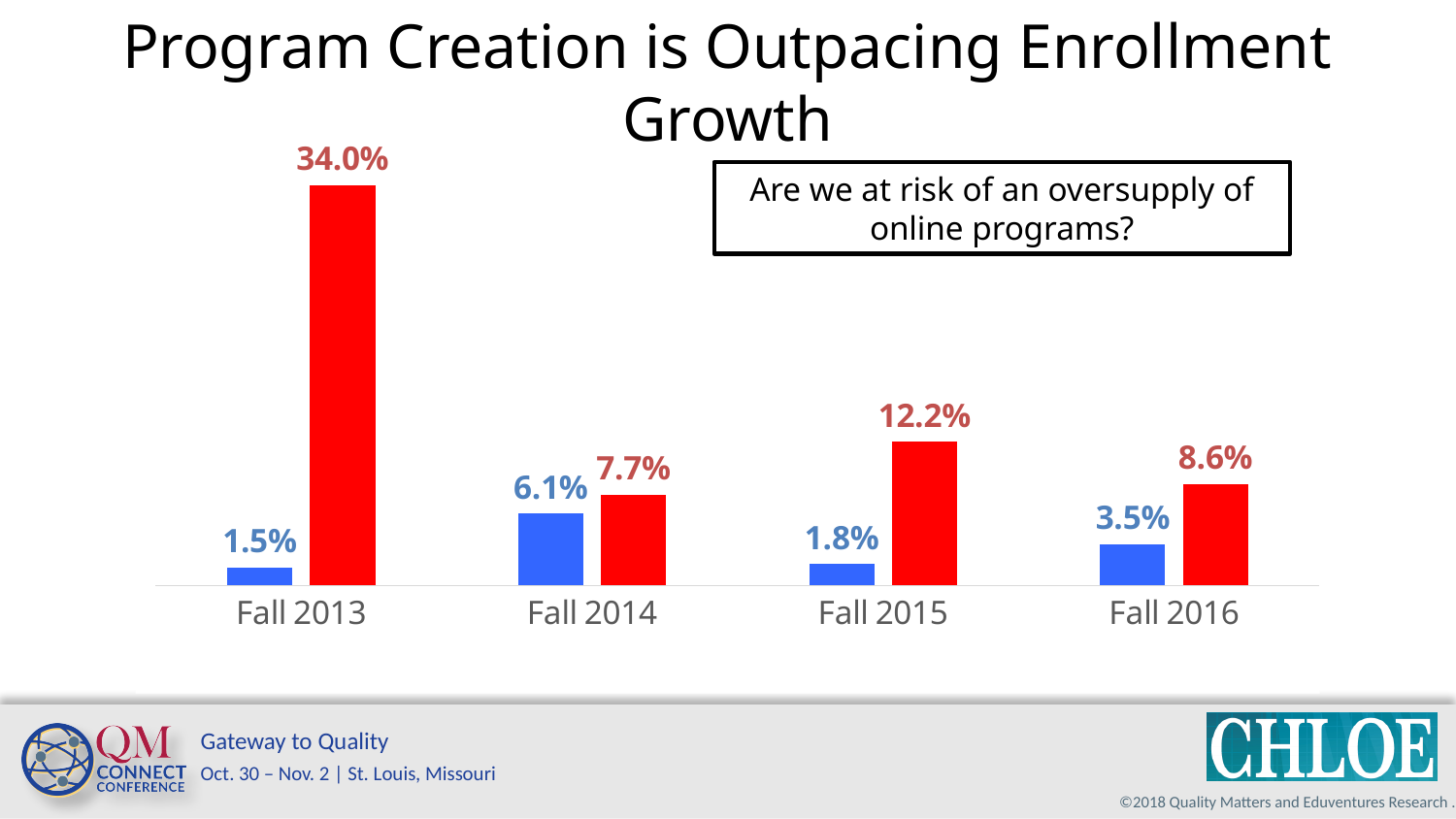
In which category is the blue bar lowest? Fall 2013 What kind of chart is shown on the slide? Bar chart In which category is the red bar highest? Fall 2013 What is the difference between the red and blue bars for Fall 2016? 5.1% What is the title of the slide containing the chart? Program Creation is Outpacing Enrollment Growth How many categories are shown on the x axis? 4 What is the value of the red bar for Fall 2013? 34.0% What is the value of the red bar for Fall 2015? 12.2% In which category is the blue bar highest? Fall 2014 What is the value of the blue bar for Fall 2016? 3.5% Which is larger, the red bar for Fall 2014 or the red bar for Fall 2016? Fall 2016 What is the value of the blue bar for Fall 2014? 6.1%